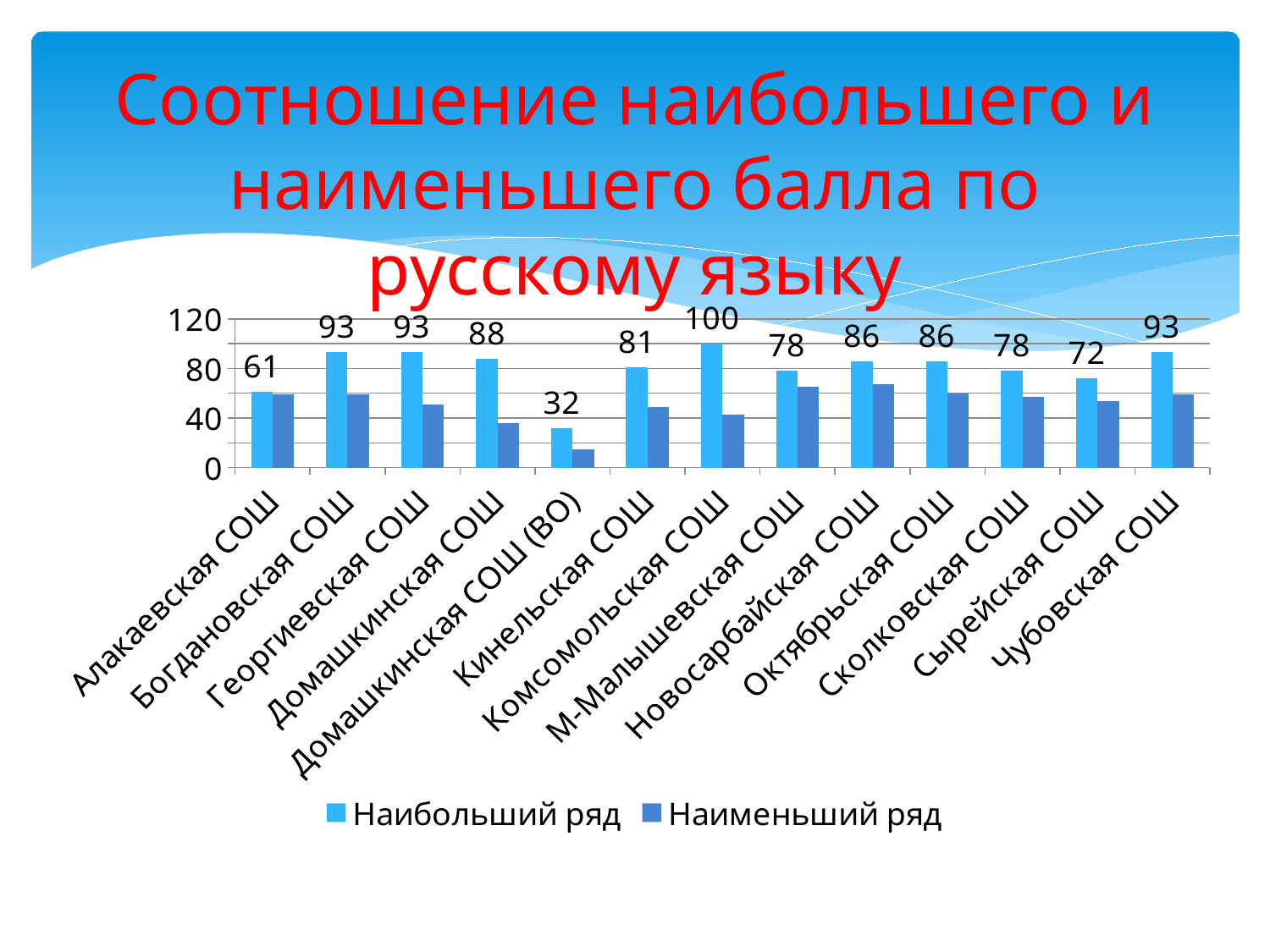
Which is larger in the Наибольший ряд series: Кинельская СОШ or Домашкинская СОШ? Домашкинская СОШ How many schools are shown on the x axis of the chart? 13 How many series does the legend list? 2 Which school has the lowest value in the Наибольший ряд series? Домашкинская СОШ (ВО) Is the Наименьший ряд value for Домашкинская СОШ (ВО) greater or less than 40? less What is the value of Наибольший ряд for Сырейская СОШ? 72 What is the difference between the Наибольший ряд values for Комсомольская СОШ and Алакаевская СОШ? 39 Which school has the highest value in the Наибольший ряд series? Комсомольская СОШ What is the value of Наибольший ряд for Домашкинская СОШ (ВО)? 32 What is the value of Наибольший ряд for Комсомольская СОШ? 100 Is the Наименьший ряд value for Новосарбайская СОШ greater or less than 40? greater What type of chart is shown on the slide? Bar chart